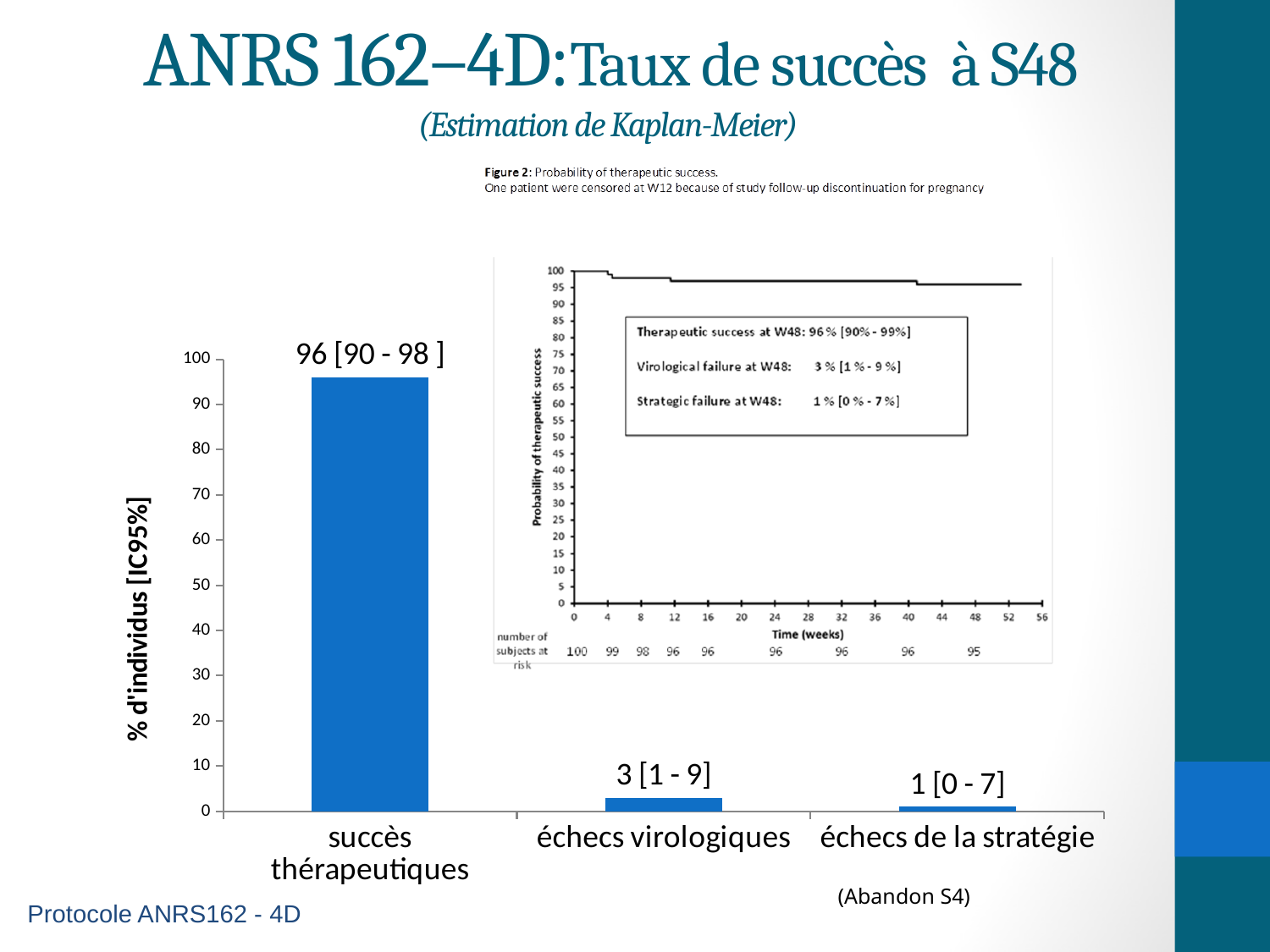
In the bar chart, what is the value for échecs virologiques? 3 How many categories does the bar chart show? 3 In the bar chart, which category has the lowest value? échecs de la stratégie What kind of chart is the chart on the left of the slide? bar chart In the bar chart, what is the difference between the values for succès thérapeutiques and échecs virologiques? 93 In the bar chart, what is the value for échecs de la stratégie? 1 In the Kaplan-Meier figure on the right, what is the therapeutic success at W48 stated in the text box? 96% [90% - 99%] In the bar chart, which is larger: échecs virologiques or échecs de la stratégie? échecs virologiques In the Kaplan-Meier figure on the right, what is the number of subjects at risk at week 0? 100 In the bar chart, what is the 95% confidence interval shown for succès thérapeutiques? [90 - 98] In the bar chart, which category has the highest value? succès thérapeutiques In the bar chart, what is the value for succès thérapeutiques? 96